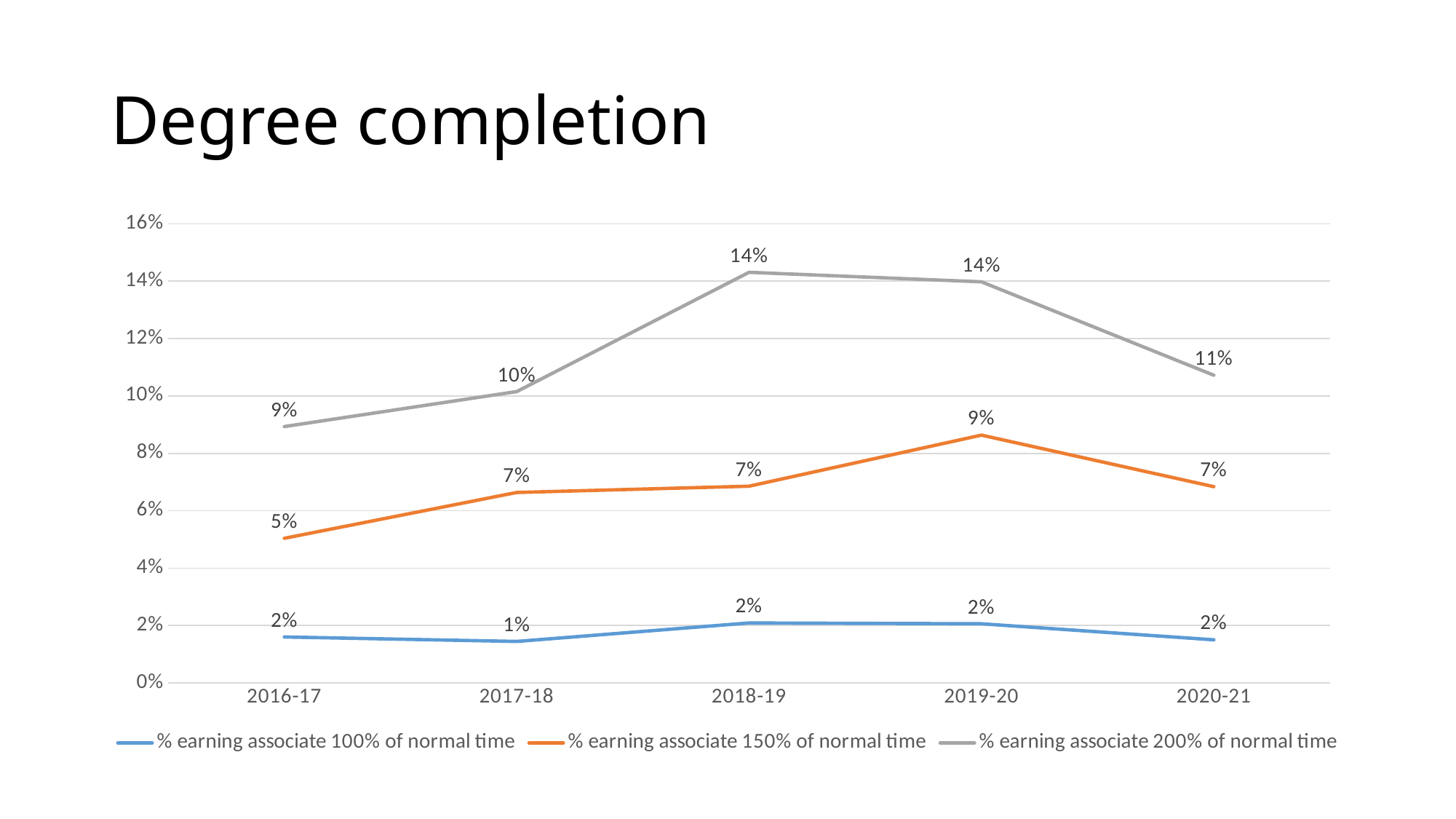
In which year is '% earning associate 200% of normal time' lowest? 2016-17 What is the value for '% earning associate 150% of normal time' in 2016-17? 5% What type of chart is shown on the slide? line chart Which is larger in 2020-21: '% earning associate 200% of normal time' or '% earning associate 150% of normal time'? % earning associate 200% of normal time What is the value for '% earning associate 100% of normal time' in 2017-18? 1% Does '% earning associate 150% of normal time' rise or fall from 2016-17 to 2019-20? rise In which year is '% earning associate 150% of normal time' highest? 2019-20 How many series does the legend list? 3 How many academic years are plotted on the x axis? 5 What is the value for '% earning associate 200% of normal time' in 2018-19? 14% Is the value for '% earning associate 200% of normal time' in 2018-19 greater or less than 12%? greater What is the difference between '% earning associate 200% of normal time' and '% earning associate 150% of normal time' in 2019-20? 5%